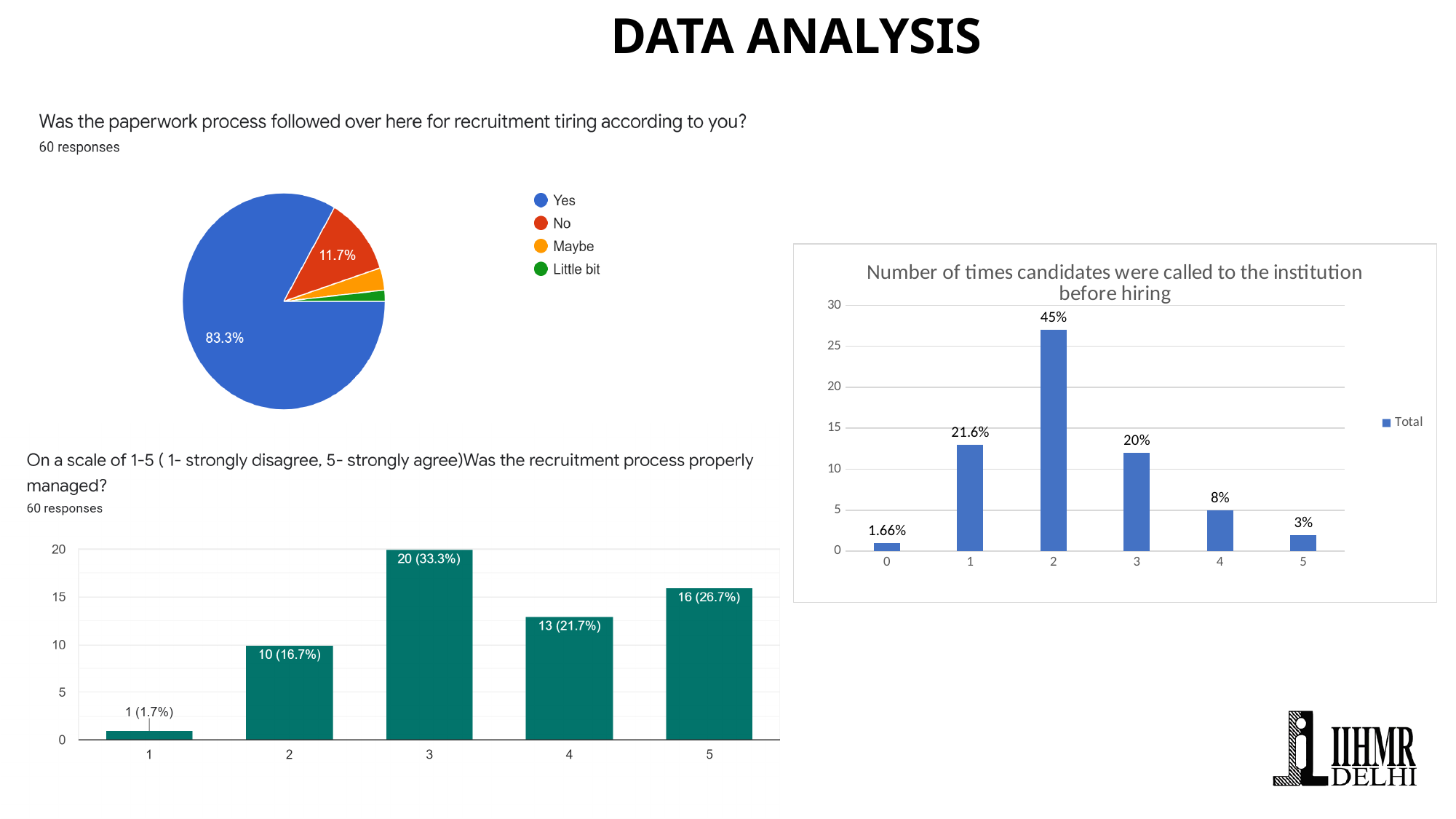
In the pie chart about the paperwork process, which category has the largest slice? Yes In the bar chart about whether the recruitment process was properly managed, what is the difference in responses between rating 5 and rating 4? 3 What type of chart is 'Number of times candidates were called to the institution before hiring'? bar chart In the chart 'Number of times candidates were called to the institution before hiring', is the bar for category 1 greater or less than 10? greater In the bar chart about whether the recruitment process was properly managed, how many responses gave a rating of 3? 20 (33.3%) In the pie chart about whether the paperwork process was tiring, what share of responses is 'No'? 11.7% In the chart 'Number of times candidates were called to the institution before hiring', what is the data label for category 2? 45% In the bar chart about whether the recruitment process was properly managed, which rating received the fewest responses? 1 How many entries does the legend of the pie chart about the paperwork process list? 4 In the chart 'Number of times candidates were called to the institution before hiring', what is the data label for category 0? 1.66% In the bar chart about whether the recruitment process was properly managed, how many rating categories are shown on the x axis? 5 In the pie chart about whether the paperwork process was tiring, what share of responses is 'Yes'? 83.3%